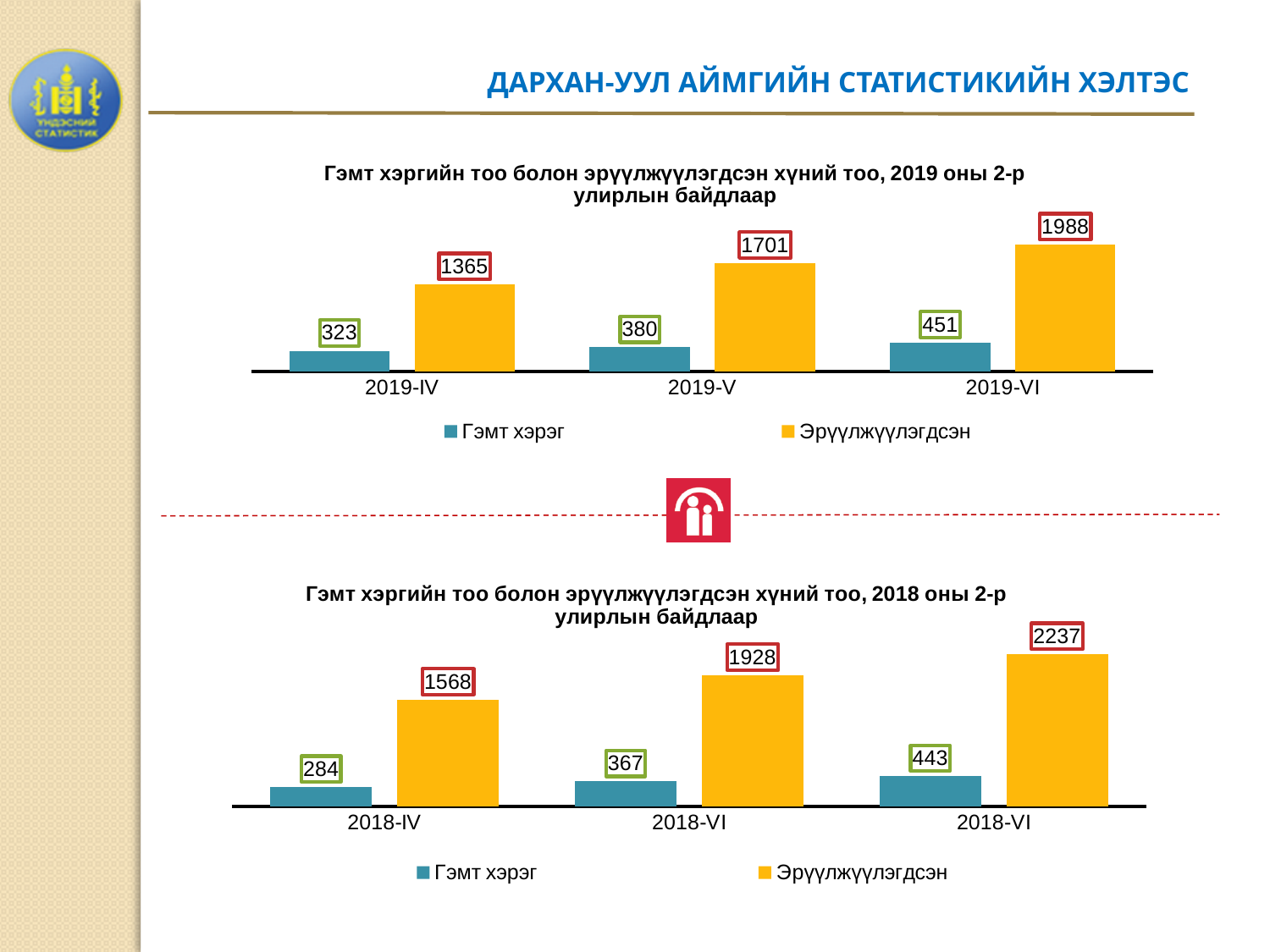
In the bottom chart (2018), what is the highest Эрүүлжүүлэгдсэн value shown? 2237 In the bottom chart (2018), how many categories are shown on the x axis? 3 In the top chart (2019), how many series does the legend list? 2 In the top chart (2019), what is the difference between the Эрүүлжүүлэгдсэн values for 2019-VI and 2019-IV? 623 In the top chart (2019), which category has the lowest Гэмт хэрэг value? 2019-IV In the top chart (2019), do the Гэмт хэрэг values rise or fall from 2019-IV to 2019-VI? rise In the bottom chart (2018), what is the difference between the Эрүүлжүүлэгдсэн value and the Гэмт хэрэг value for 2018-IV? 1284 In the top chart (2019), which category has the highest Эрүүлжүүлэгдсэн value? 2019-VI In the top chart (2019), what is the value of Гэмт хэрэг for 2019-IV? 323 In the top chart (2019), what is the value of Эрүүлжүүлэгдсэн for 2019-V? 1701 What type of chart is the bottom chart (2018)? bar chart In the bottom chart (2018), what is the value of Гэмт хэрэг for 2018-IV? 284